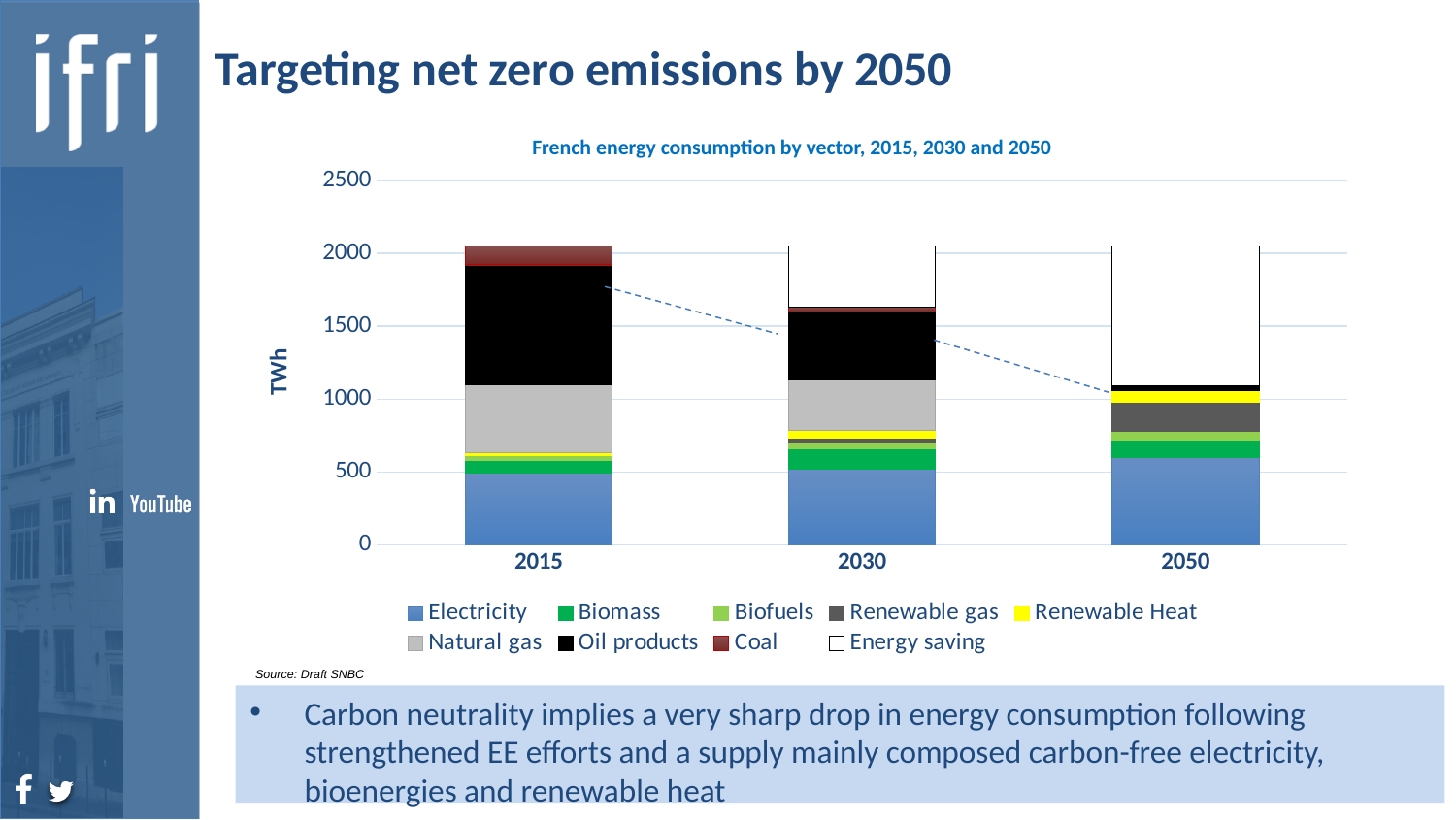
Does the Oil products segment rise or fall from 2015 to 2050? Fall Which year has the largest Energy saving segment? 2050 Is the value for Electricity in 2050 greater or less than 500? greater Which series is the largest segment in the 2015 bar? Oil products What kind of chart is shown on the slide? Stacked bar chart Is the Electricity segment larger in 2015 or in 2050? 2050 What is the title of the chart? French energy consumption by vector, 2015, 2030 and 2050 How many years (categories) are shown on the x axis? 3 How many series does the legend list? 9 What unit is shown on the y axis? TWh Which year has the largest Oil products segment? 2015 Is the value for Oil products in 2015 greater or less than 500? greater